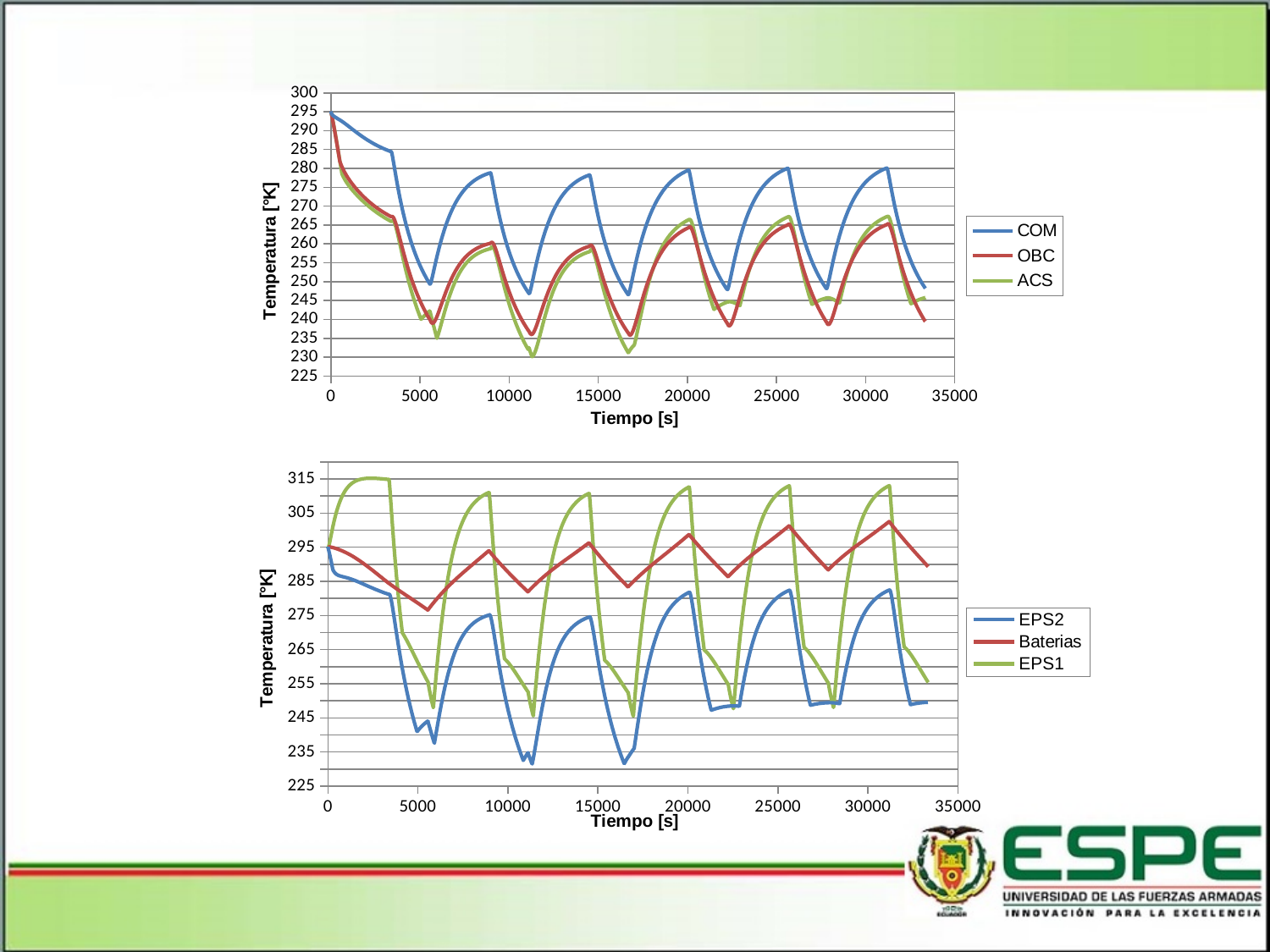
On the bottom chart, which series drops to the lowest temperature? EPS2 On the top chart, which series reaches the highest temperatures? COM What kind of chart is the top chart? Line chart On the bottom chart, which series is drawn in red? Baterias On the top chart, is the COM value at time 0 greater or less than 290? greater On the bottom chart, which series reaches the highest temperatures? EPS1 On the top chart, what is the label of the x axis? Tiempo [s] On the top chart, which series drops to the lowest temperature? ACS On the bottom chart, is the highest value reached by EPS1 greater or less than 305? greater On the bottom chart, how many series does the legend list? 3 On the top chart, how many series does the legend list? 3 On the top chart, is the lowest value reached by ACS greater or less than 235? less